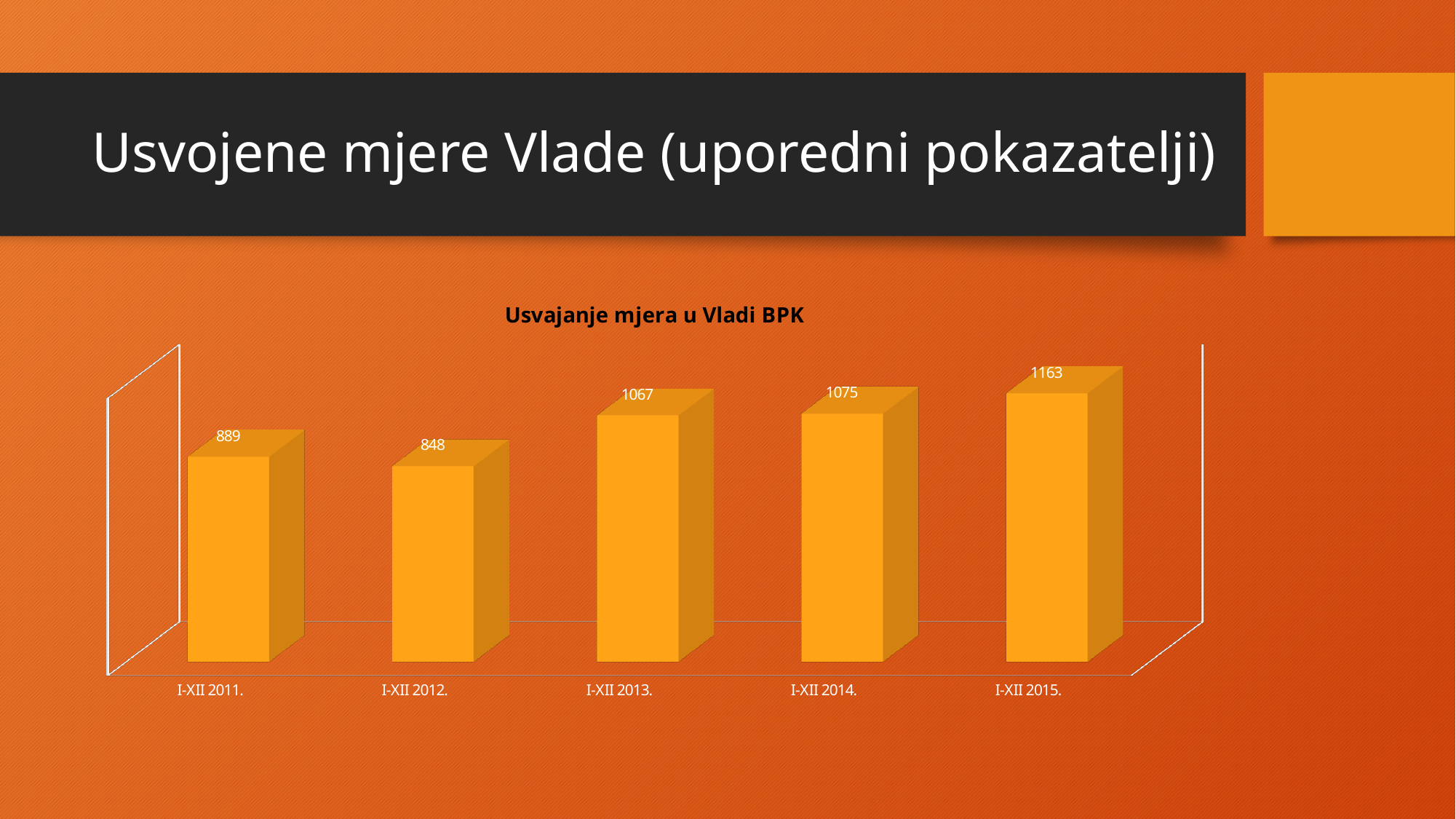
What is the title of the chart? Usvajanje mjera u Vladi BPK What is the value for I-XII 2013.? 1067 How many periods are shown on the x axis? 5 Which period has the lowest value? I-XII 2012. What kind of chart is shown? bar chart Which is larger, the value for I-XII 2011. or the value for I-XII 2012.? I-XII 2011. What is the difference between the values for I-XII 2015. and I-XII 2011.? 274 Which period has the highest value? I-XII 2015. What is the value for I-XII 2015.? 1163 What is the difference between the values for I-XII 2013. and I-XII 2012.? 219 Do the values generally rise or fall from I-XII 2012. to I-XII 2015.? rise What is the value for I-XII 2011.? 889